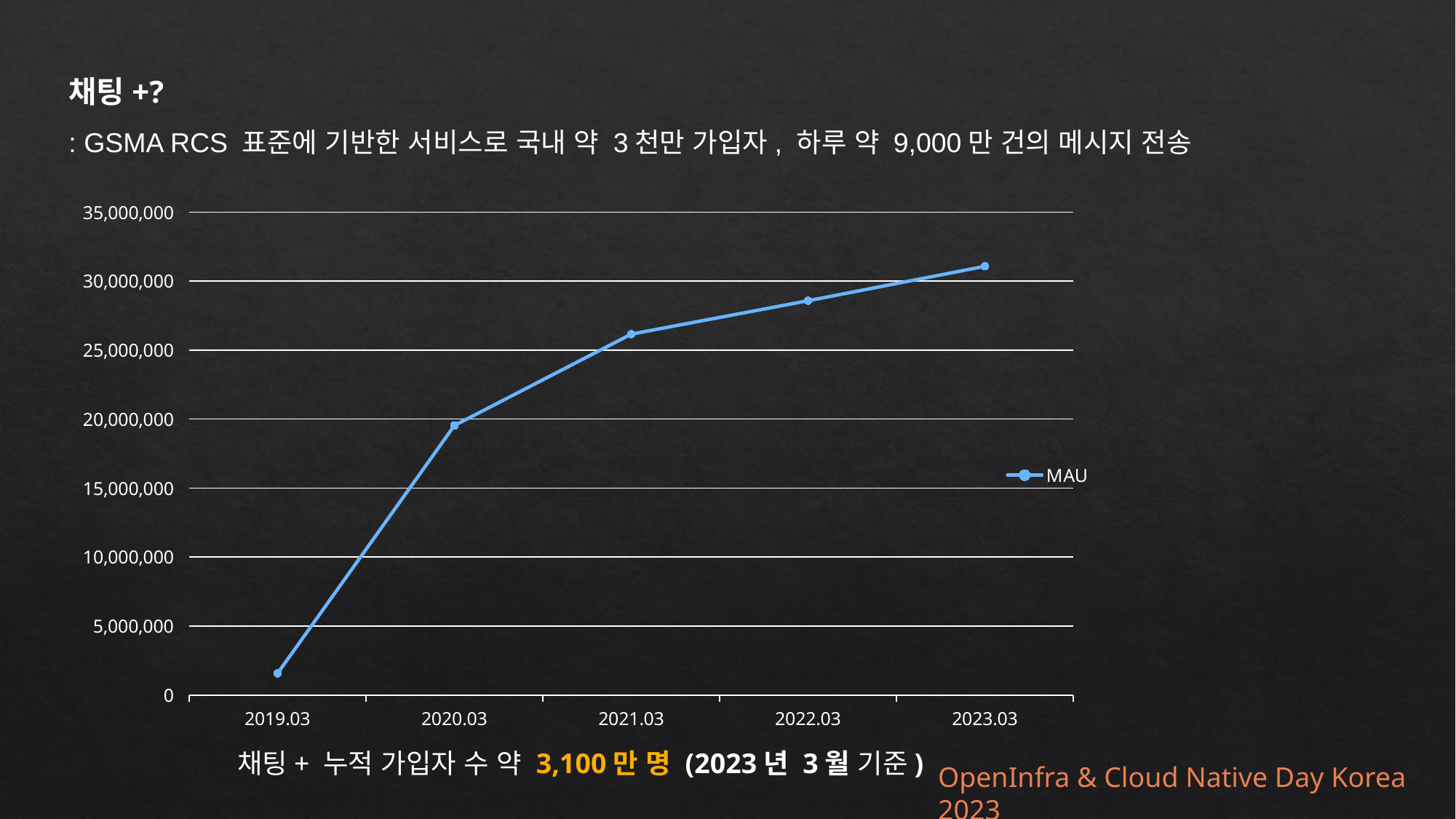
Is the MAU value for 2023.03 greater or less than 30,000,000? greater Do the MAU values rise or fall from 2019.03 to 2023.03? rise How many series does the legend list? 1 What is the name of the series shown in the legend? MAU Which x-axis category has the lowest MAU value? 2019.03 How many data points are plotted on the MAU line? 5 Which x-axis category has the highest MAU value? 2023.03 Is the MAU value for 2019.03 greater or less than 5,000,000? less Which has the larger MAU value, 2020.03 or 2021.03? 2021.03 Is the MAU value for 2022.03 greater or less than 25,000,000? greater What kind of chart is shown on the slide? line chart